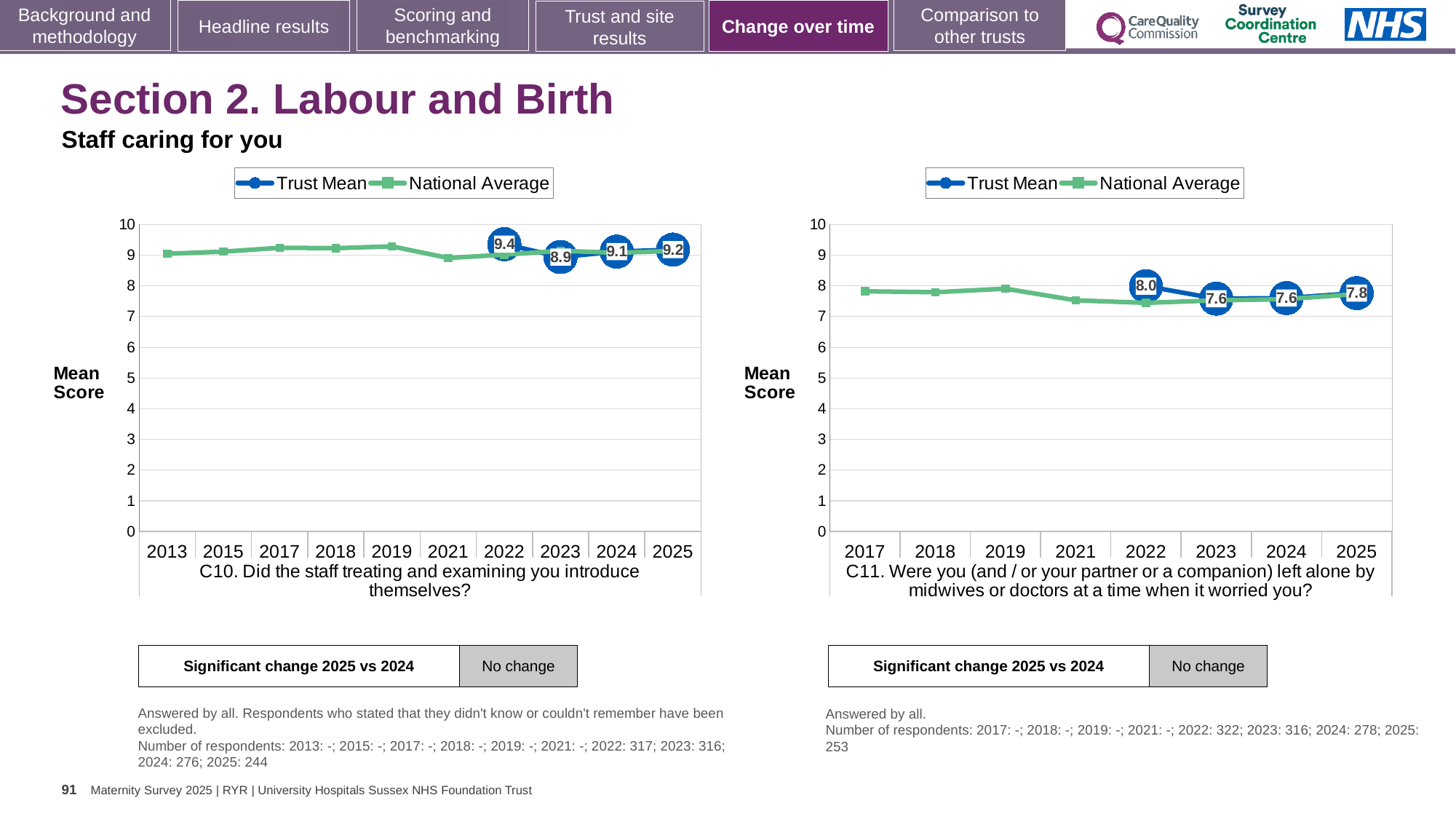
In the C10 chart on the left, what is the difference between the Trust Mean for 2022 and 2023? 0.5 In the C10 chart on the left, which year has the highest labelled Trust Mean? 2022 In the C11 chart on the right, what is the Trust Mean for 2025? 7.8 In the C11 chart on the right, what is the Trust Mean for 2022? 8.0 How many series does the legend of the C11 chart on the right list? 2 What type of chart is the C10 chart on the left? Line chart In the C11 chart on the right, which year has the lowest labelled Trust Mean? 2023 and 2024 In the C10 chart on the left, what is the Trust Mean for 2023? 8.9 In the C11 chart on the right, is the National Average for 2019 greater or less than 7? greater How many years are shown on the x axis of the C10 chart on the left? 10 In the C10 chart on the left, what is the Trust Mean for 2025? 9.2 In the C11 chart on the right, is the Trust Mean for 2025 larger than the Trust Mean for 2024? Yes